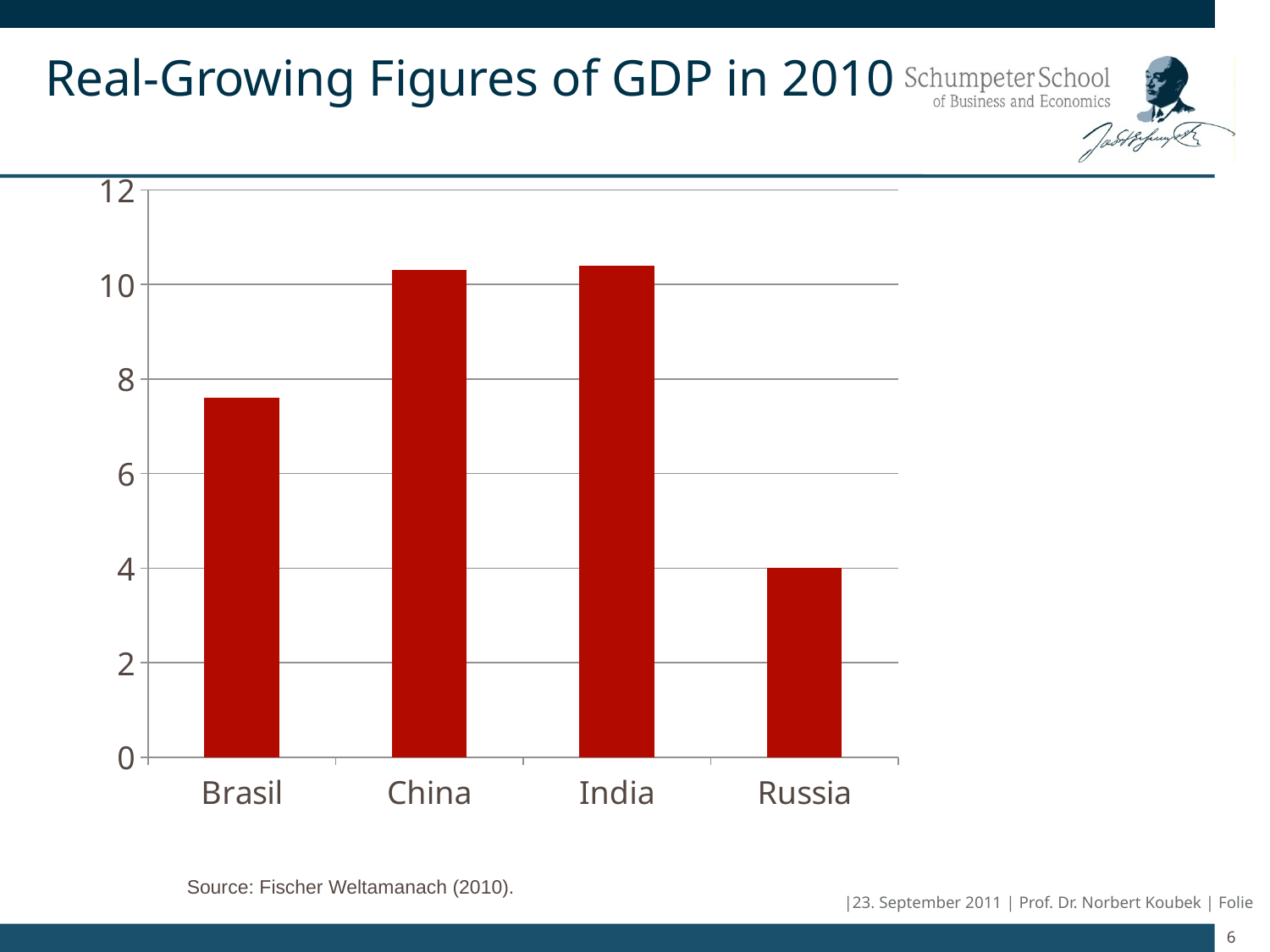
Is the value for Brasil greater or less than 6? greater Which is larger, the value for China or the value for Brasil? China Which country has the lowest value in the chart? Russia What kind of chart is shown on the slide? bar chart Is the value for India greater or less than 10? greater Is the value for Brasil greater or less than 8? less What colour are the bars in the chart? dark red How many countries are shown on the x axis of the chart? 4 What is the value for Russia? 4 What is the title of the slide containing the chart? Real-Growing Figures of GDP in 2010 Which is larger, the value for Brasil or the value for Russia? Brasil